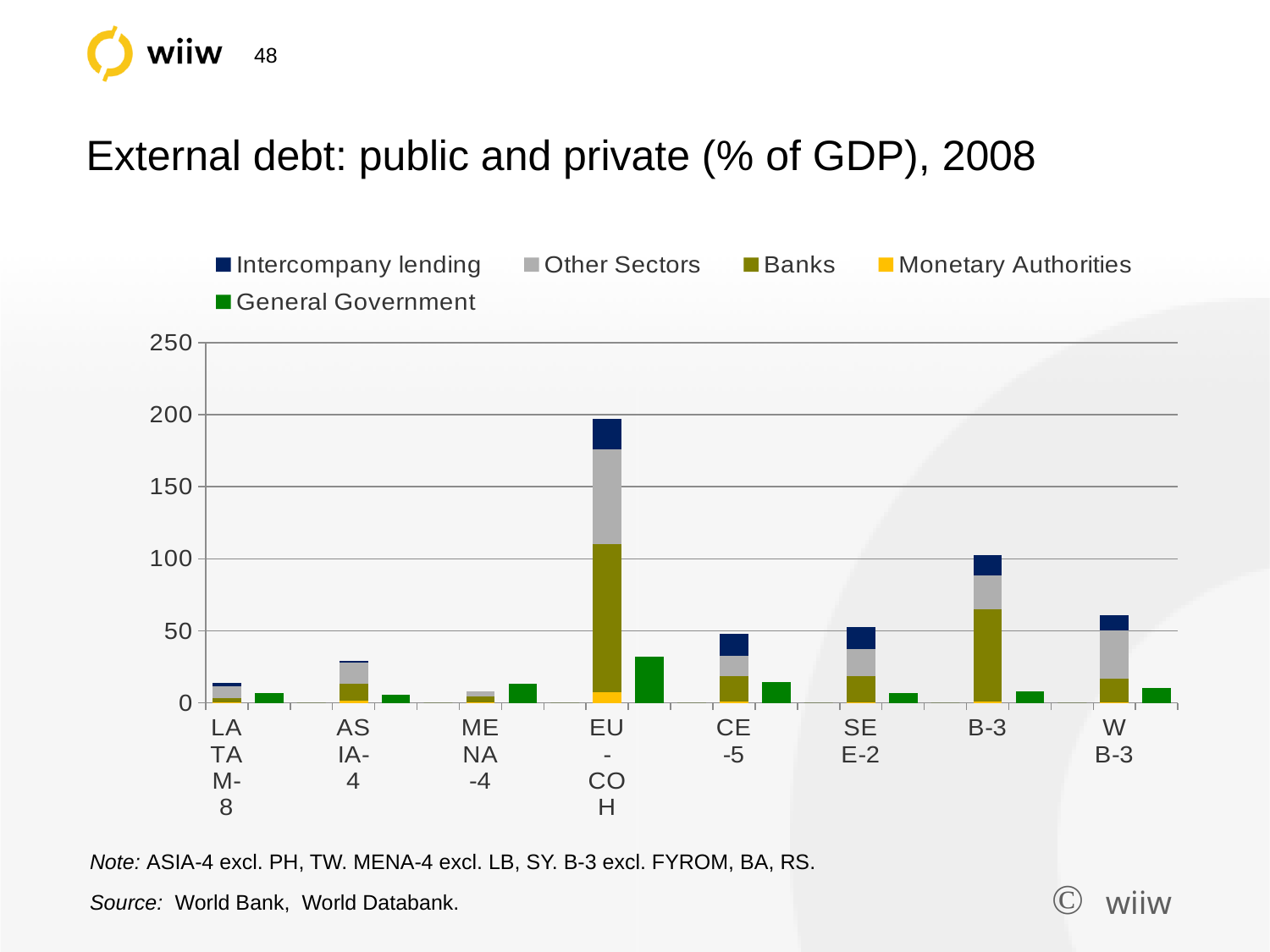
Is the stacked bar for ASIA-4 greater or less than 50? less Which country group has the highest General Government external debt bar? EU-COH Is the General Government bar for EU-COH greater or less than 50? less How many country groups are shown on the x axis? 8 Is the stacked bar for WB-3 greater or less than 50? greater Which series is shown in yellow in the legend? Monetary Authorities What kind of chart is shown on the slide? Stacked bar chart How many series does the legend list? 5 What is the title of the chart? External debt: public and private (% of GDP), 2008 Which stacked bar is taller, EU-COH or B-3? EU-COH Which country group has the highest stacked bar of private external debt? EU-COH